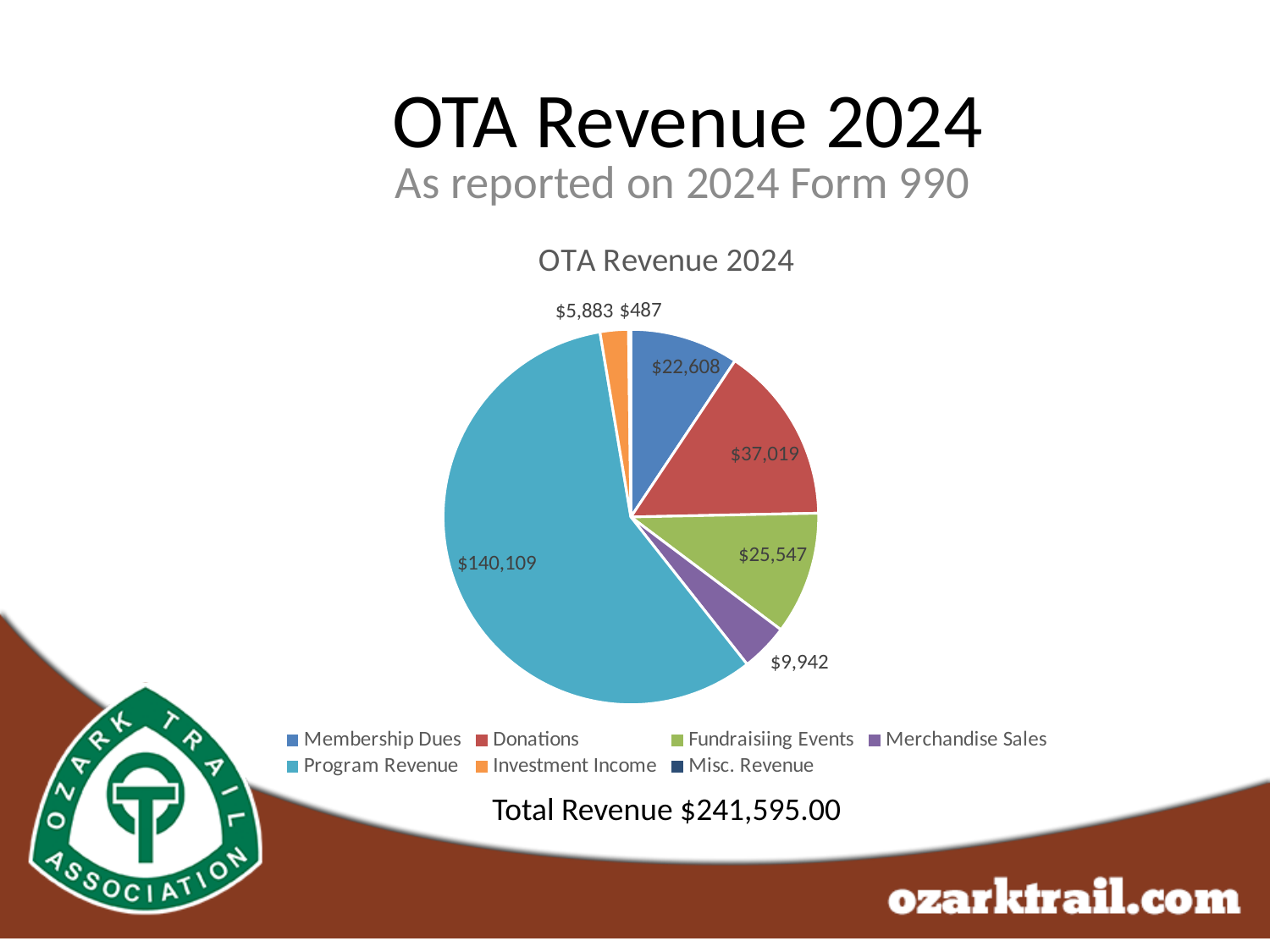
What is the title of the chart? OTA Revenue 2024 Which is larger, Fundraisiing Events or Membership Dues? Fundraisiing Events Which revenue category has the smallest slice of the pie? Misc. Revenue What is the value of the Investment Income slice? $5,883 What is the value of the Merchandise Sales slice? $9,942 What is the difference between the Donations value and the Membership Dues value? $14,411 What is the value of the Membership Dues slice? $22,608 What is the value of the Donations slice? $37,019 Which revenue category has the largest slice of the pie? Program Revenue What kind of chart is shown on the slide? Pie chart What is the value of the Program Revenue slice in the OTA Revenue 2024 pie chart? $140,109 How many revenue categories are listed in the chart legend? 7